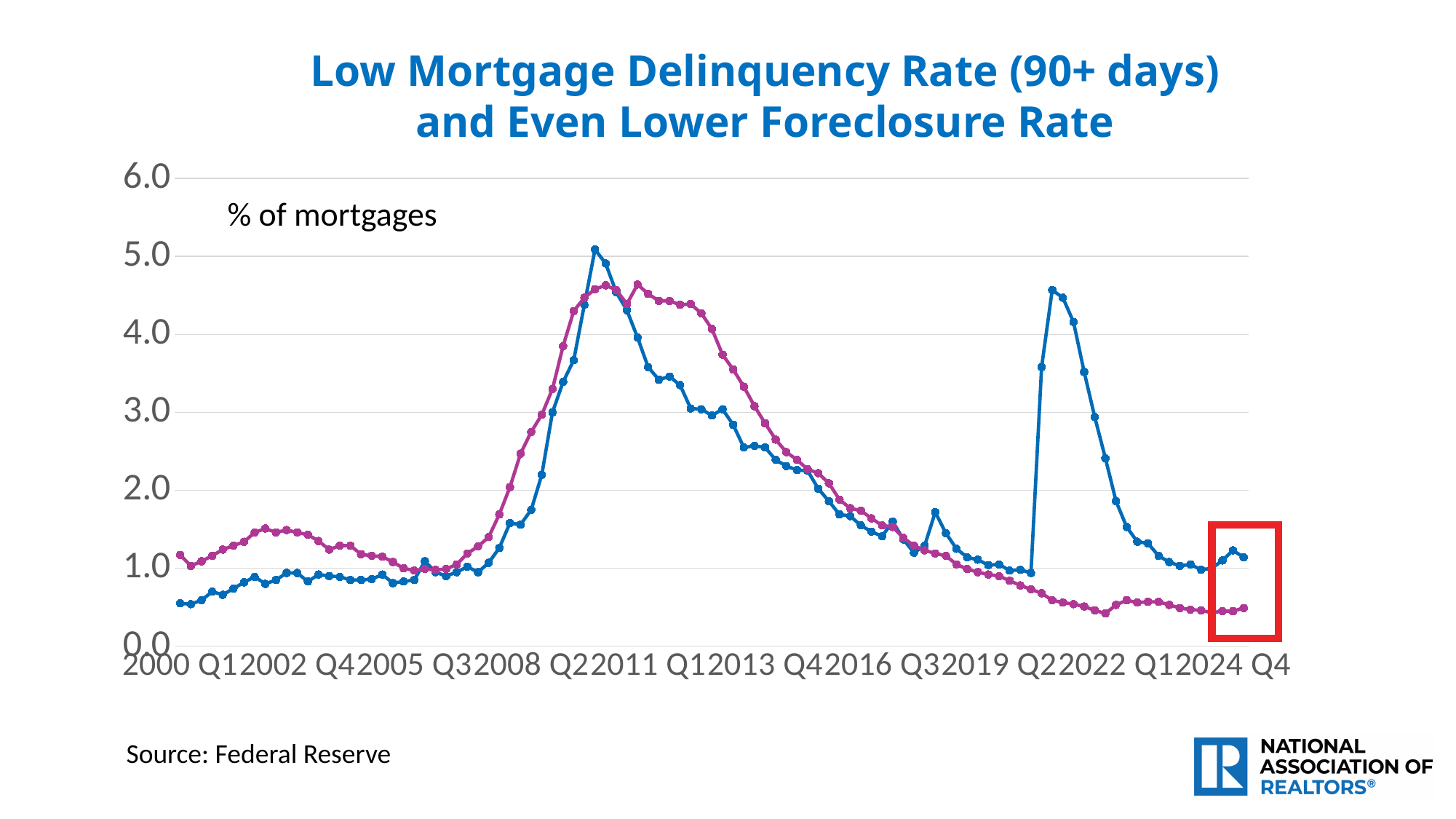
Is the value of the blue line at 2000 Q1 greater or less than 1.0? less Which line reaches the highest value on the chart, the blue line or the pink line? The blue line What kind of chart is shown on the slide? Line chart Is the peak value of the blue line greater or less than 4.0? greater Is the value of the pink line at 2024 Q4 greater or less than 1.0? less At 2000 Q1, which line is higher, the blue line or the pink line? The pink line How many lines (data series) are plotted on the chart? 2 At 2024 Q4, which line is higher, the blue line or the pink line? The blue line Between 2011 Q1 and 2019 Q2, does the pink line generally rise or fall? Fall What is the source cited for the chart data? Federal Reserve